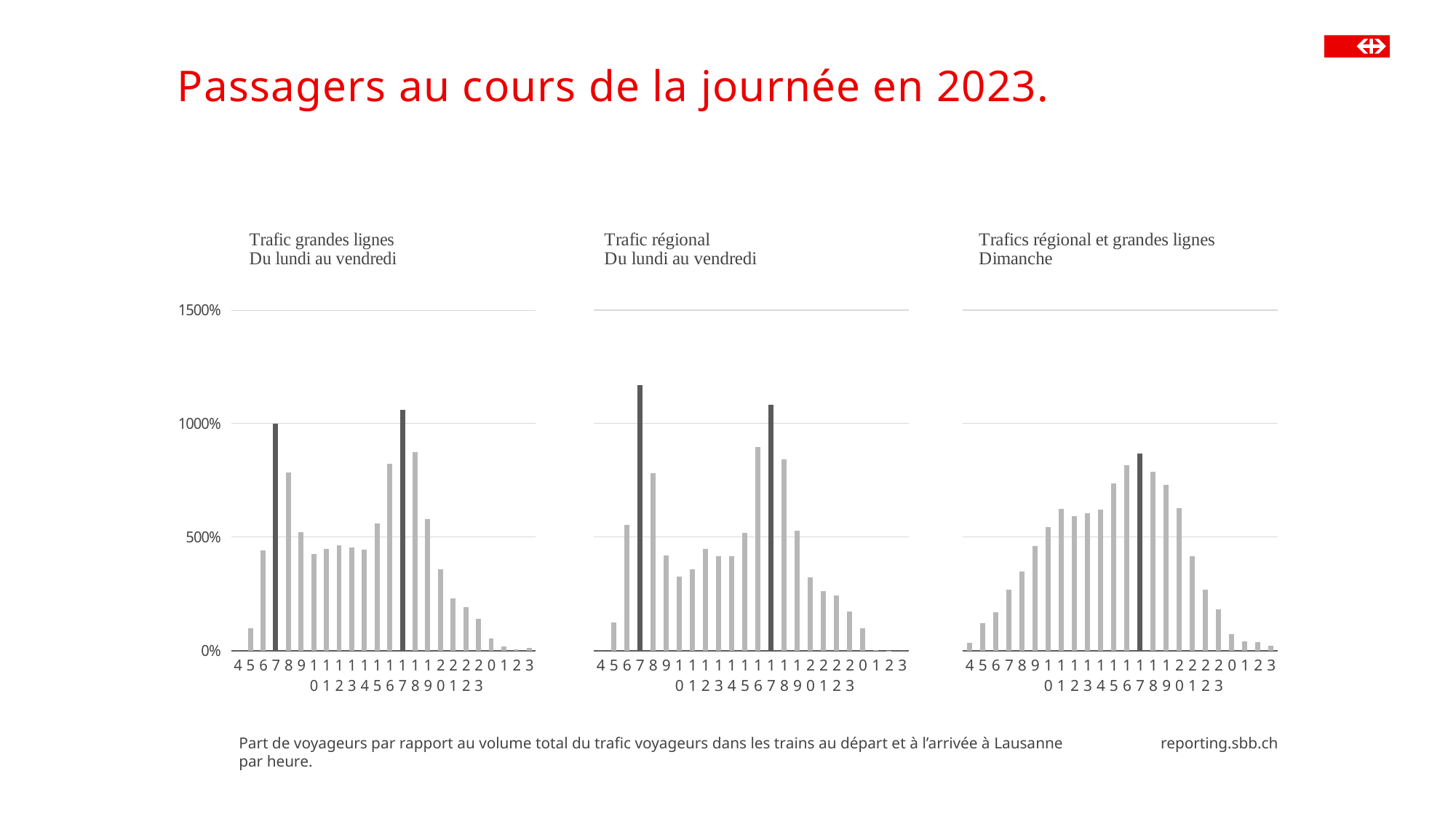
In the right chart, 'Trafics régional et grandes lignes, Dimanche', which hour has the highest value? 17 In the left chart, 'Trafic grandes lignes, Du lundi au vendredi', which is larger, the value for hour 8 or the value for hour 9? hour 8 In the right chart, 'Trafics régional et grandes lignes, Dimanche', is the value for hour 17 greater or less than 1000%? less What kind of chart is the left chart, 'Trafic grandes lignes, Du lundi au vendredi'? bar chart In the middle chart, 'Trafic régional, Du lundi au vendredi', is the value for hour 16 greater or less than 1000%? less In the left chart, 'Trafic grandes lignes, Du lundi au vendredi', is the value for hour 17 greater or less than 1000%? greater How many hour categories are plotted on the x axis of the right chart, 'Trafics régional et grandes lignes, Dimanche'? 24 In the middle chart, 'Trafic régional, Du lundi au vendredi', which is larger, the value for hour 7 or the value for hour 17? hour 7 How many charts are shown on the slide? 3 In the middle chart, 'Trafic régional, Du lundi au vendredi', which hour has the highest value? 7 In the right chart, 'Trafics régional et grandes lignes, Dimanche', do the values rise or fall from hour 4 to hour 17? rise